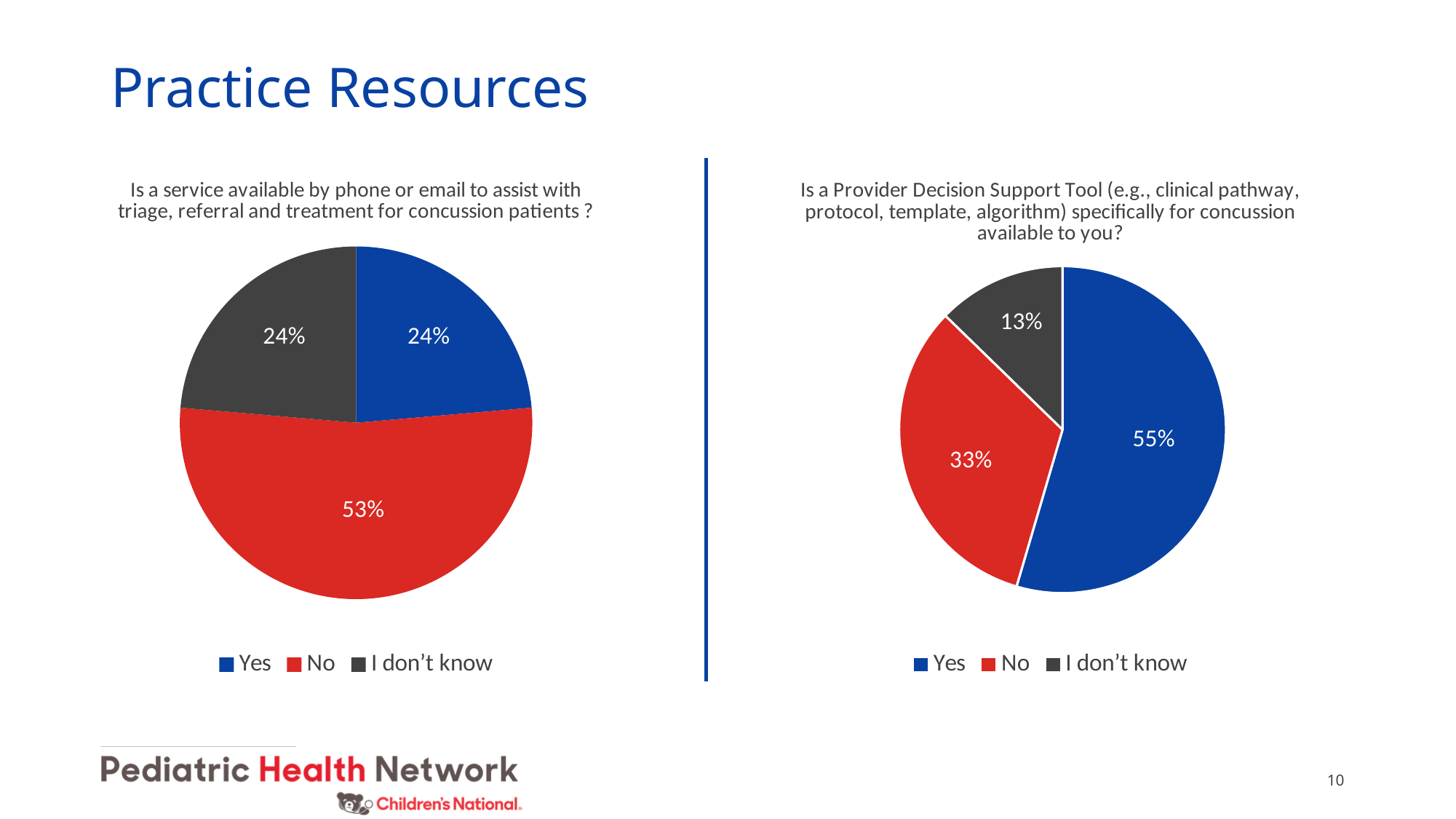
In the right pie chart (Provider Decision Support Tool), what share of respondents answered Yes? 55% In the left pie chart (service available by phone or email), what share of respondents answered Yes? 24% In the right pie chart (Provider Decision Support Tool), which response has the largest share? Yes How many entries does the legend of the right pie chart list? 3 In the left pie chart (service available by phone or email), what share of respondents answered No? 53% In the right pie chart (Provider Decision Support Tool), which response has the smallest share? I don't know In the right pie chart (Provider Decision Support Tool), what share of respondents answered I don't know? 13% In the right pie chart (Provider Decision Support Tool), which is larger, the No share or the I don't know share? No What type of chart is used on the left side of the slide? Pie chart In the left pie chart (service available by phone or email), what is the difference between the No and Yes shares? 29% In the left pie chart (service available by phone or email), which response has the largest share? No In the right pie chart (Provider Decision Support Tool), what is the difference between the Yes and No shares? 22%